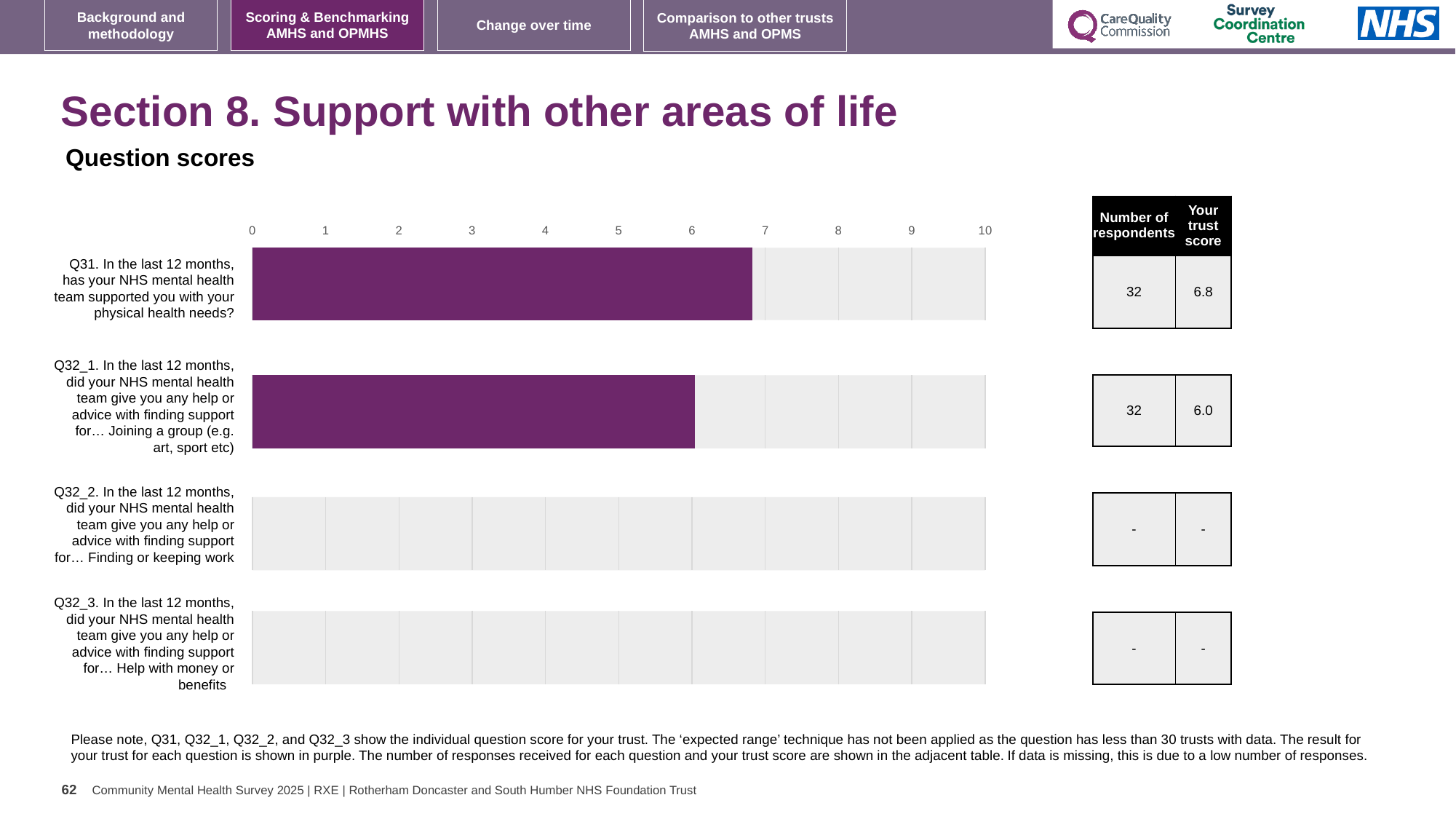
What is the trust score for Q32_1 (help or advice with finding support for joining a group)? 6.0 Which has the larger trust score, Q31 or Q32_1? Q31 How many respondents answered Q32_1? 32 Which question has the highest trust score on the chart? Q31 What is the difference between the trust scores for Q31 and Q32_1? 0.8 How many questions are listed on the chart? 4 How many respondents answered Q31? 32 What trust score is shown for Q32_2 (finding or keeping work)? - What is the trust score for Q31 (supported you with your physical health needs)? 6.8 What is the maximum value shown on the chart's axis? 10 Is the trust score for Q32_1 greater or less than 7? less What kind of chart is shown on the slide? Bar chart